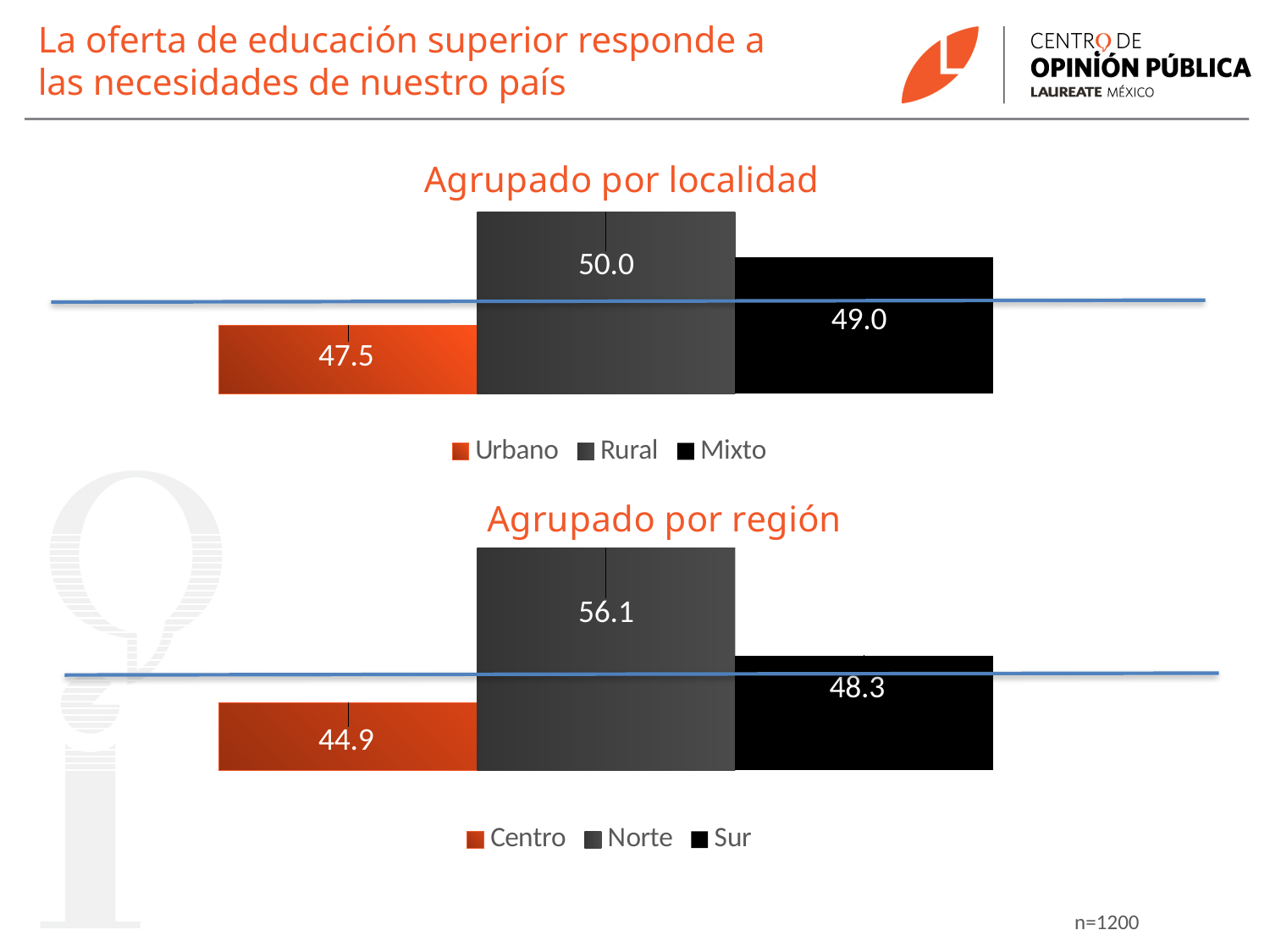
In the 'Agrupado por región' chart, which region has the highest value? Norte In the 'Agrupado por localidad' chart, what is the value for Mixto? 49.0 In the 'Agrupado por región' chart, what is the value for Norte? 56.1 In the 'Agrupado por región' chart, what is the value for Sur? 48.3 In the 'Agrupado por región' chart, what is the value for Centro? 44.9 In the 'Agrupado por localidad' chart, which group has the highest value? Rural In the 'Agrupado por localidad' chart, what is the value for Urbano? 47.5 How many series does the legend of the 'Agrupado por región' chart list? 3 In the 'Agrupado por localidad' chart, what is the difference between the Rural and Urbano values? 2.5 In the 'Agrupado por región' chart, what is the difference between the Norte and Centro values? 11.2 In the 'Agrupado por localidad' chart, what is the value for Rural? 50.0 In the 'Agrupado por localidad' chart, which group has the lowest value? Urbano